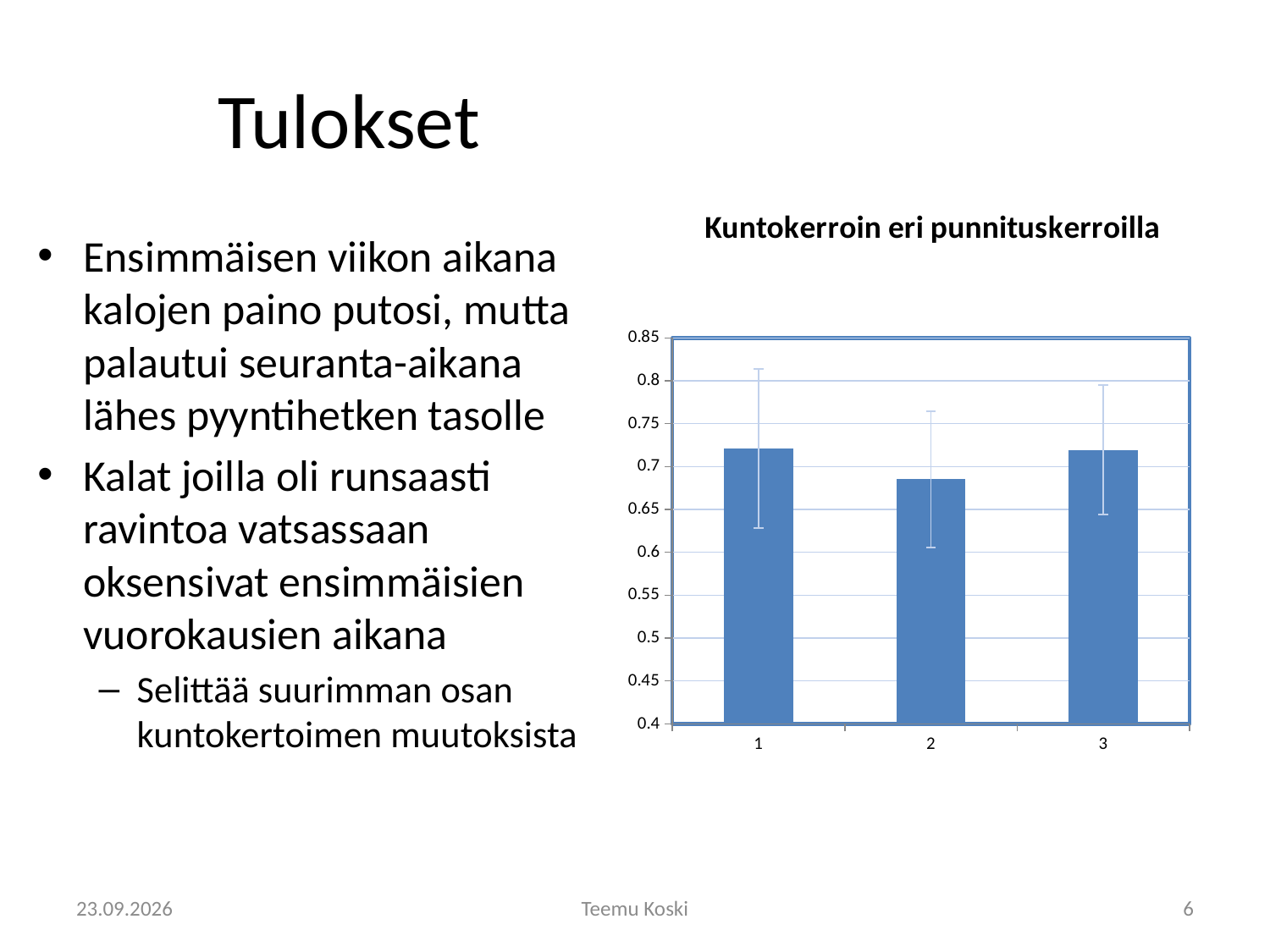
What kind of chart is shown on the slide? bar chart Is the value for category 2 greater or less than 0.7? less Which is larger, the value for category 1 or the value for category 2? category 1 What is the lowest value shown on the vertical axis of the chart? 0.4 What is the title of the chart? Kuntokerroin eri punnituskerroilla How many bars (categories) does the chart show? 3 Is the value for category 3 greater or less than 0.7? greater Which category has the lowest value in the chart? 2 Which is larger, the value for category 2 or the value for category 3? category 3 Is the value for category 1 greater or less than 0.7? greater